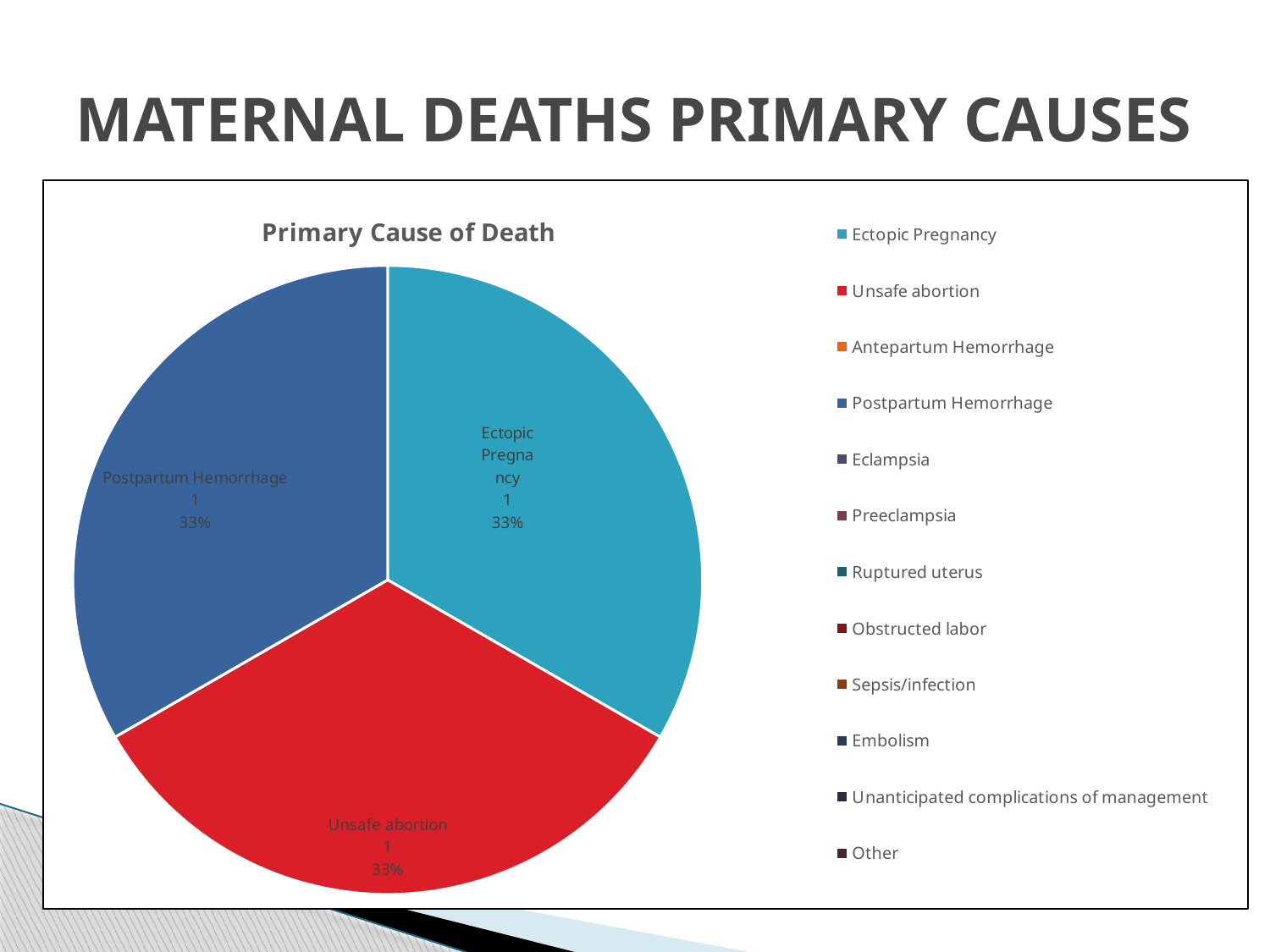
What value is shown for the Unsafe abortion slice? 1 How many slices does the pie chart have? 3 What value is shown for the Postpartum Hemorrhage slice? 1 What share of the pie does the Ectopic Pregnancy slice represent? 33% What type of chart is shown on the slide? pie chart What share of the pie does the Postpartum Hemorrhage slice represent? 33% How many entries does the legend list? 12 What colour is the Unsafe abortion slice? red What value is shown for the Ectopic Pregnancy slice? 1 What is the total of the values shown on the pie slices? 3 What is the title of the chart? Primary Cause of Death What share of the pie does the Unsafe abortion slice represent? 33%